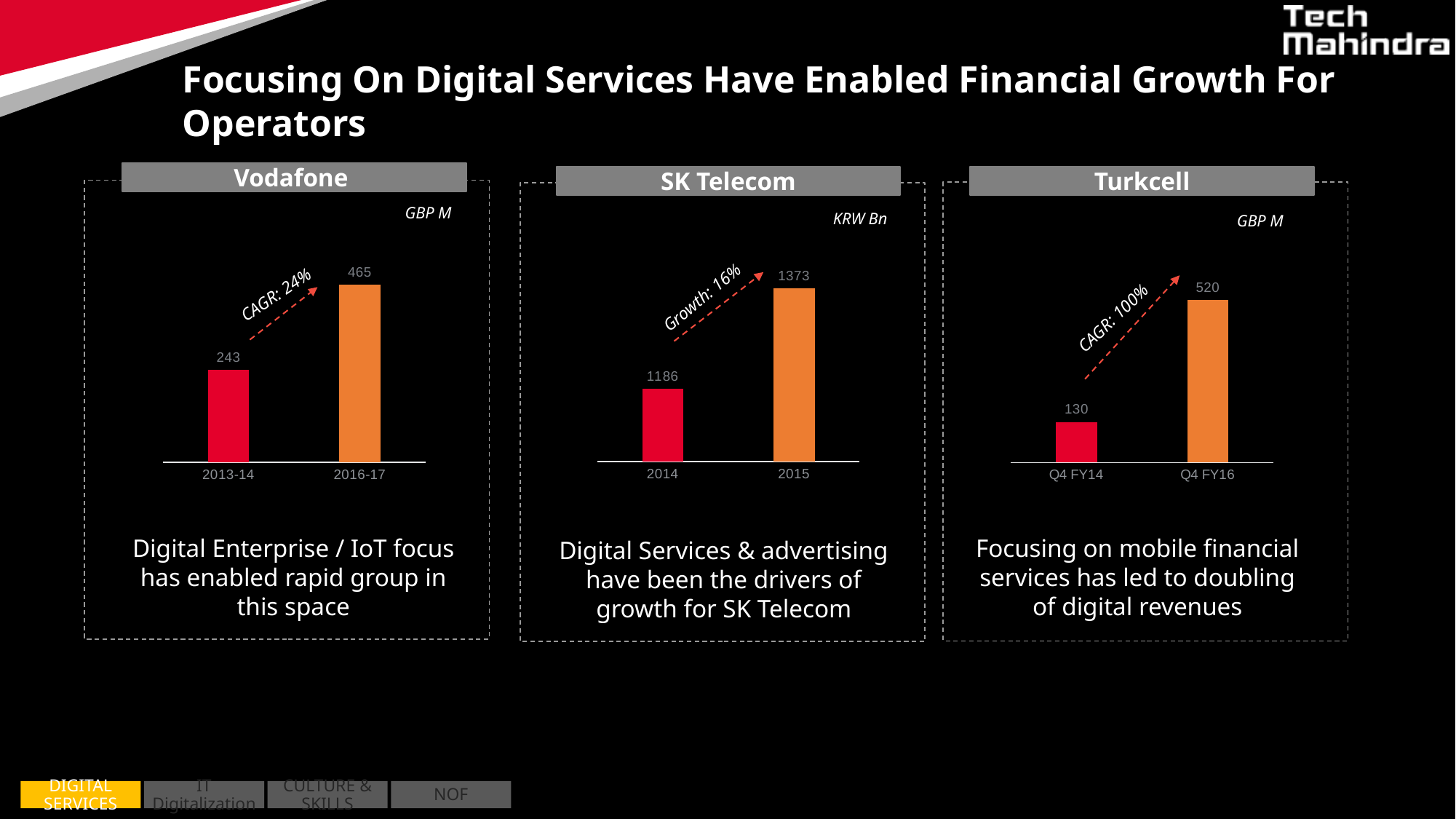
How many bars are plotted in the Vodafone chart? 2 In the Turkcell chart, what is the difference between the Q4 FY16 and Q4 FY14 values? 390 In the SK Telecom chart, which year has the higher value, 2014 or 2015? 2015 What kind of chart is the SK Telecom chart? Bar chart In the Turkcell chart, what is the value for Q4 FY16? 520 In the Vodafone chart, what is the difference between the 2016-17 and 2013-14 values? 222 What unit is shown for the SK Telecom chart? KRW Bn In the Vodafone chart, what is the value for 2013-14? 243 In the SK Telecom chart, what is the value for 2014? 1186 In the Turkcell chart, which category has the lowest value? Q4 FY14 In the Vodafone chart, what is the value for 2016-17? 465 In the SK Telecom chart, what is the value for 2015? 1373